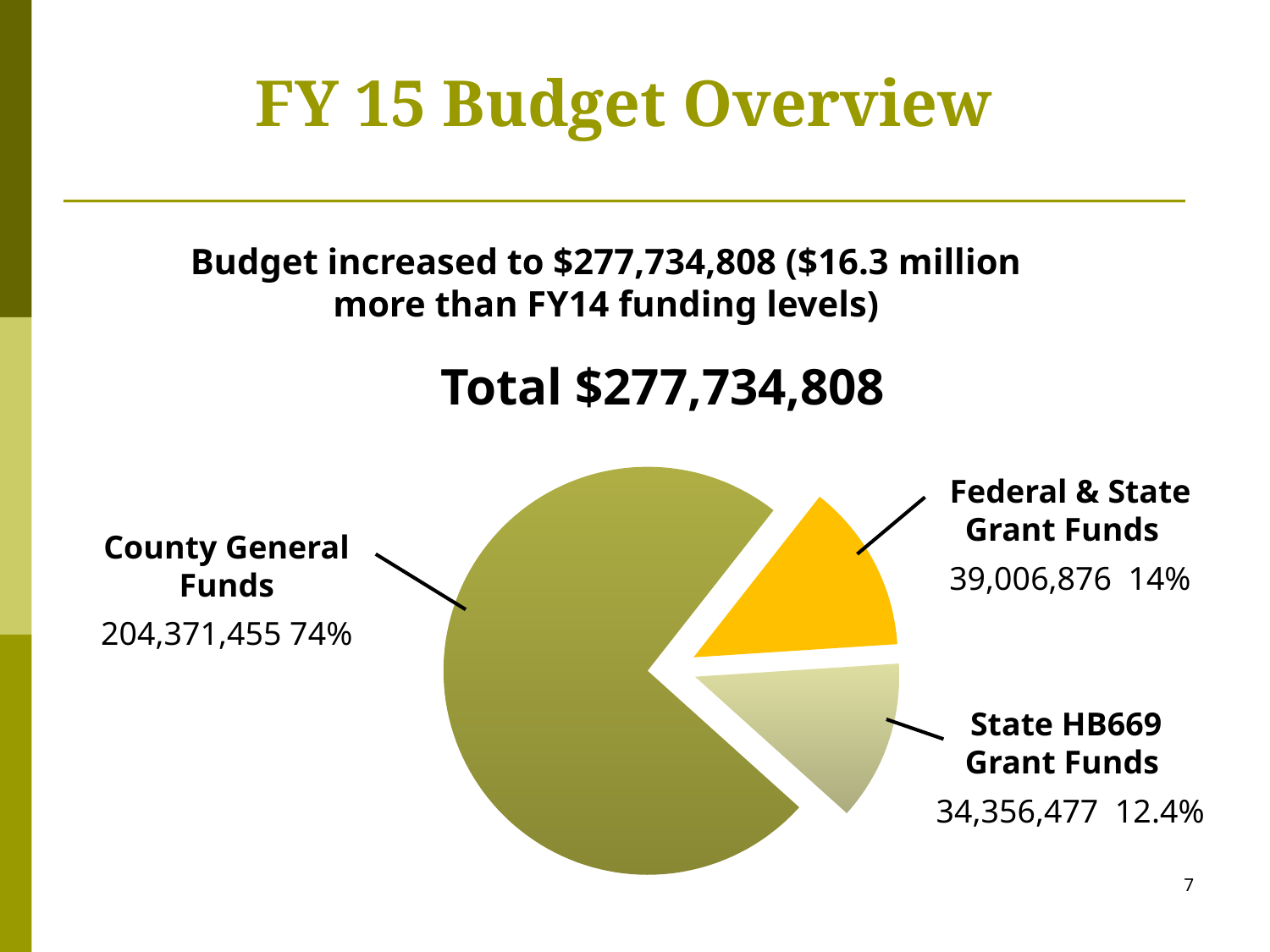
What share of the pie is County General Funds? 74% What is the total of all three slices shown on the slide? $277,734,808 What is the value for Federal & State Grant Funds? 39,006,876 What is the value for State HB669 Grant Funds? 34,356,477 Which category has the largest slice of the pie? County General Funds Which is larger, Federal & State Grant Funds or State HB669 Grant Funds? Federal & State Grant Funds What kind of chart is shown on the slide? Pie chart What share of the pie is State HB669 Grant Funds? 12.4% What is the value for County General Funds? 204,371,455 How many slices does the pie chart have? 3 Which category has the smallest slice of the pie? State HB669 Grant Funds What is the difference between Federal & State Grant Funds and State HB669 Grant Funds? 4,650,399